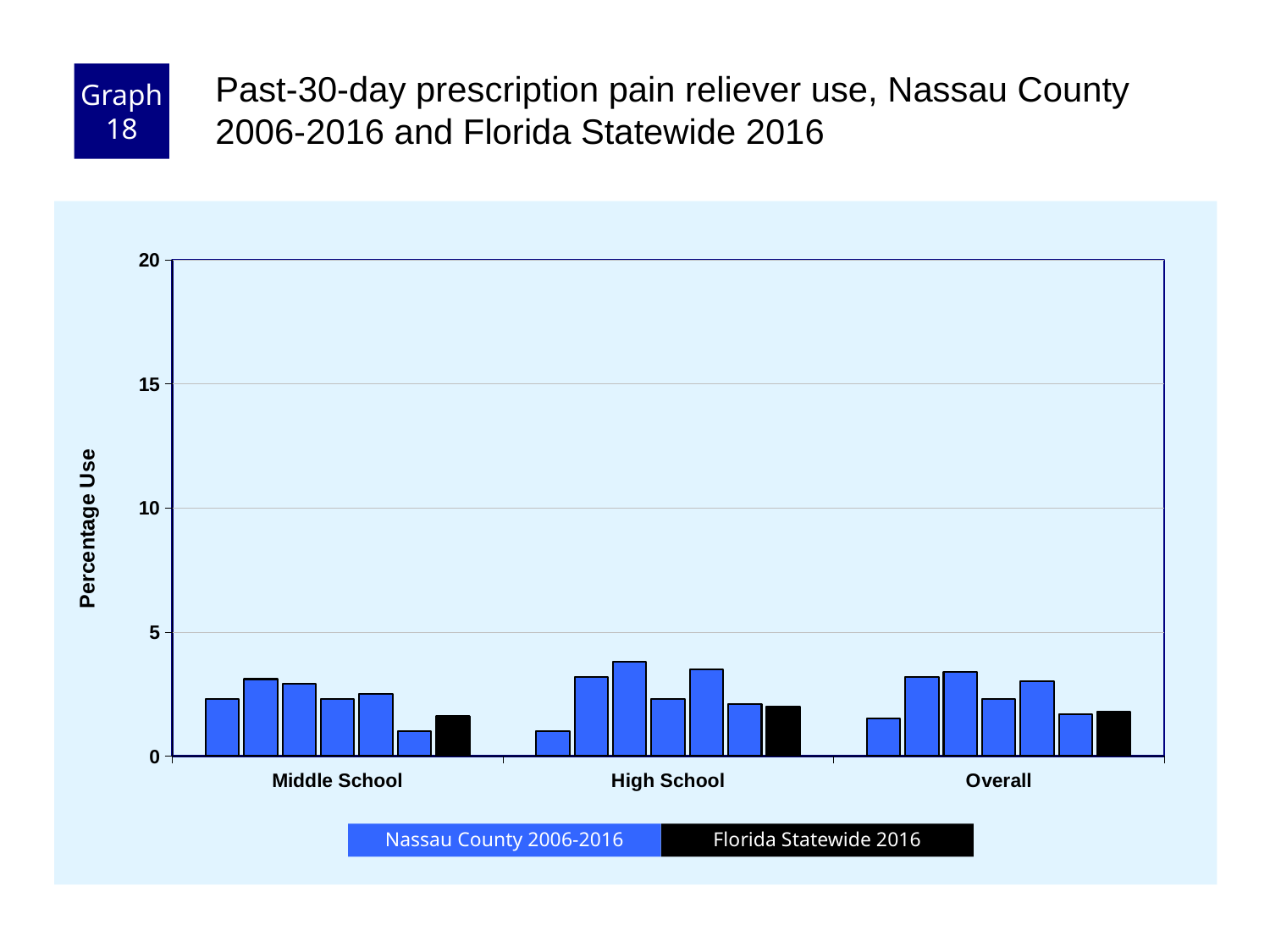
How many Nassau County 2006-2016 bars are plotted in the Middle School group? 6 What kind of chart is shown on the slide? bar chart How many bars are plotted in the High School group? 7 How many groups are shown on the x axis of the chart? 3 Is the Florida Statewide 2016 value for Overall greater or less than 5? less How many series does the legend list? 2 Is the Florida Statewide 2016 value for High School greater or less than 5? less Which group contains the tallest bar in the chart? High School What is the label on the y axis? Percentage Use Are any of the bars in the chart greater than 10? No What are the two series named in the legend? Nassau County 2006-2016 and Florida Statewide 2016